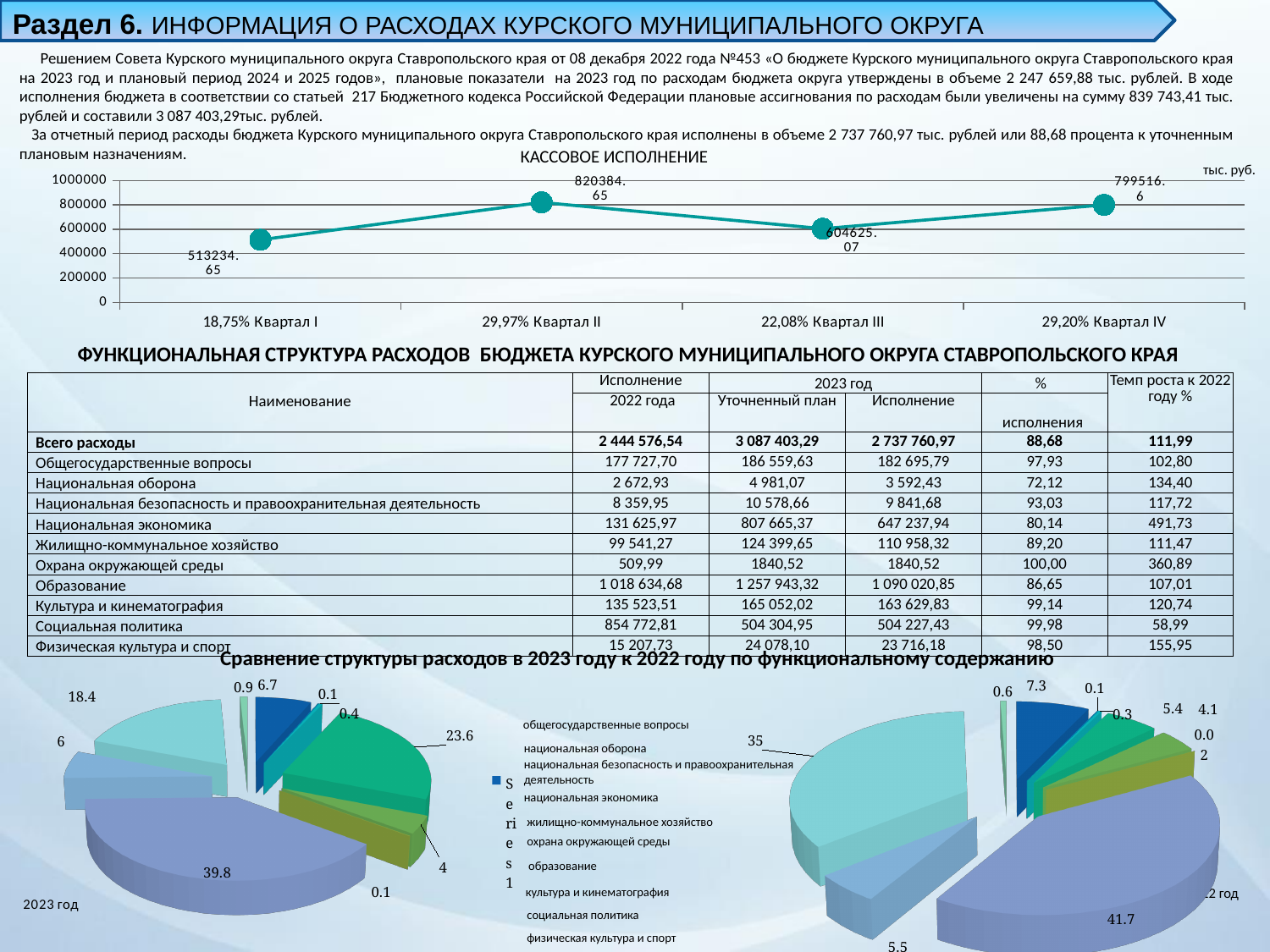
On the КАССОВОЕ ИСПОЛНЕНИЕ chart, what is the value for 29,20% Квартал IV? 799516.6 On the КАССОВОЕ ИСПОЛНЕНИЕ chart, is the value for Квартал I greater or less than 600000? less What kind of chart is the КАССОВОЕ ИСПОЛНЕНИЕ chart? line chart On the КАССОВОЕ ИСПОЛНЕНИЕ chart, what is the difference between the values for Квартал II and Квартал I? 307150 On the КАССОВОЕ ИСПОЛНЕНИЕ chart, which quarter has the highest value? 29,97% Квартал II How many quarters are plotted on the КАССОВОЕ ИСПОЛНЕНИЕ chart? 4 On the КАССОВОЕ ИСПОЛНЕНИЕ chart, what is the value for 22,08% Квартал III? 604625.07 On the КАССОВОЕ ИСПОЛНЕНИЕ chart, what is the value for 29,97% Квартал II? 820384.65 On the КАССОВОЕ ИСПОЛНЕНИЕ chart, which quarter has the lowest value? 18,75% Квартал I On the КАССОВОЕ ИСПОЛНЕНИЕ chart, does the value rise or fall from Квартал II to Квартал III? fall On the КАССОВОЕ ИСПОЛНЕНИЕ chart, which is larger, the value for Квартал III or Квартал IV? Квартал IV On the КАССОВОЕ ИСПОЛНЕНИЕ chart, what is the value for 18,75% Квартал I? 513234.65